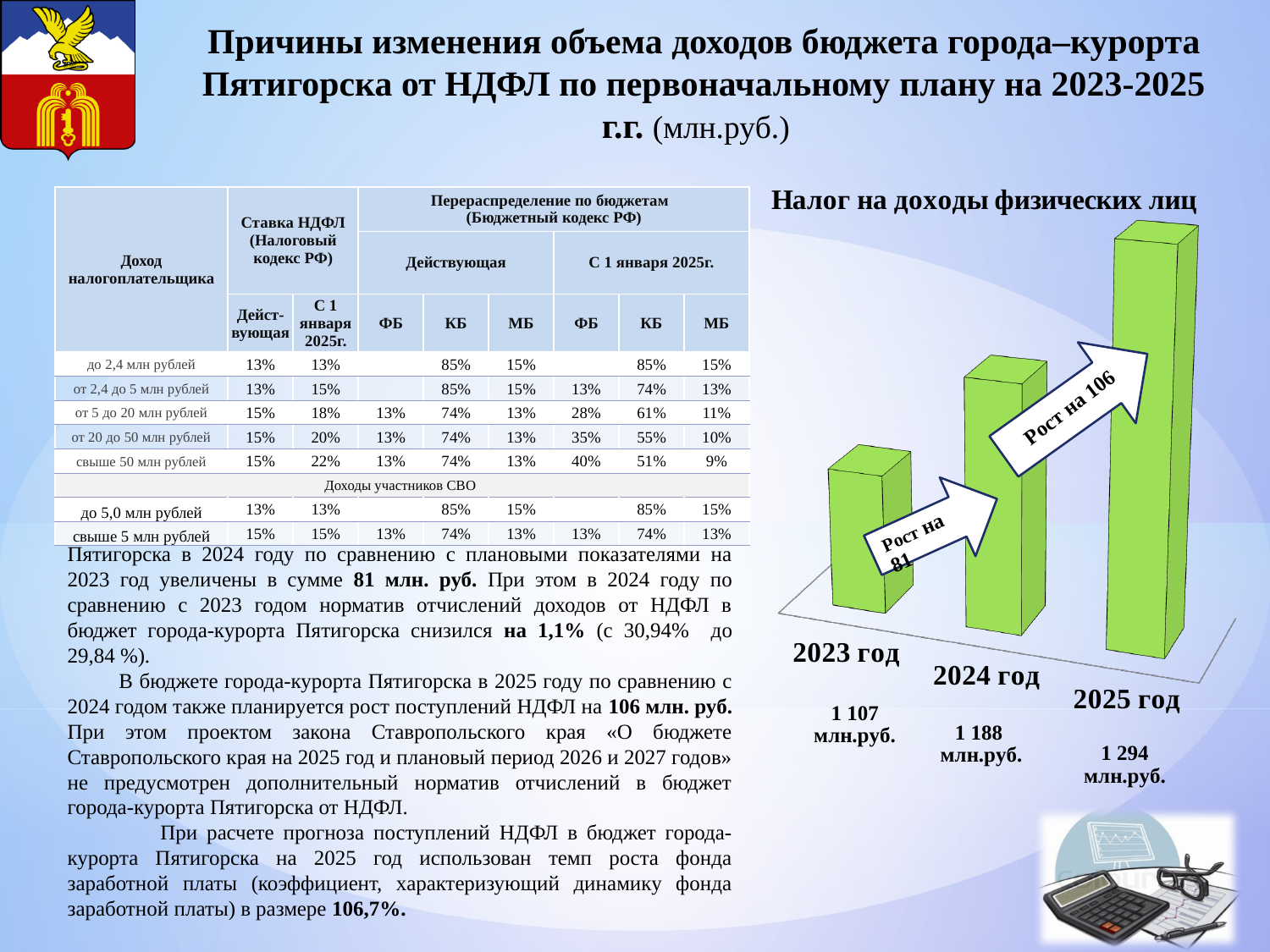
Which year has the lowest value in the chart 'Налог на доходы физических лиц'? 2023 год What is the title of the chart on the right side of the slide? Налог на доходы физических лиц What is the value for 2025 год in the chart 'Налог на доходы физических лиц'? 1 294 млн.руб. In the chart 'Налог на доходы физических лиц', which is larger: the value for 2024 год or the value for 2025 год? 2025 год In the chart 'Налог на доходы физических лиц', what is the difference between the values for 2025 год and 2024 год? 106 млн.руб. What kind of chart is 'Налог на доходы физических лиц'? Bar chart What is the value for 2024 год in the chart 'Налог на доходы физических лиц'? 1 188 млн.руб. Which year has the highest value in the chart 'Налог на доходы физических лиц'? 2025 год What is the value for 2023 год in the chart 'Налог на доходы физических лиц'? 1 107 млн.руб. In the chart 'Налог на доходы физических лиц', what is the difference between the values for 2024 год and 2023 год? 81 млн.руб. Do the values in the chart 'Налог на доходы физических лиц' rise or fall from 2023 год to 2025 год? Rise How many years (bars) are shown in the chart 'Налог на доходы физических лиц'? 3